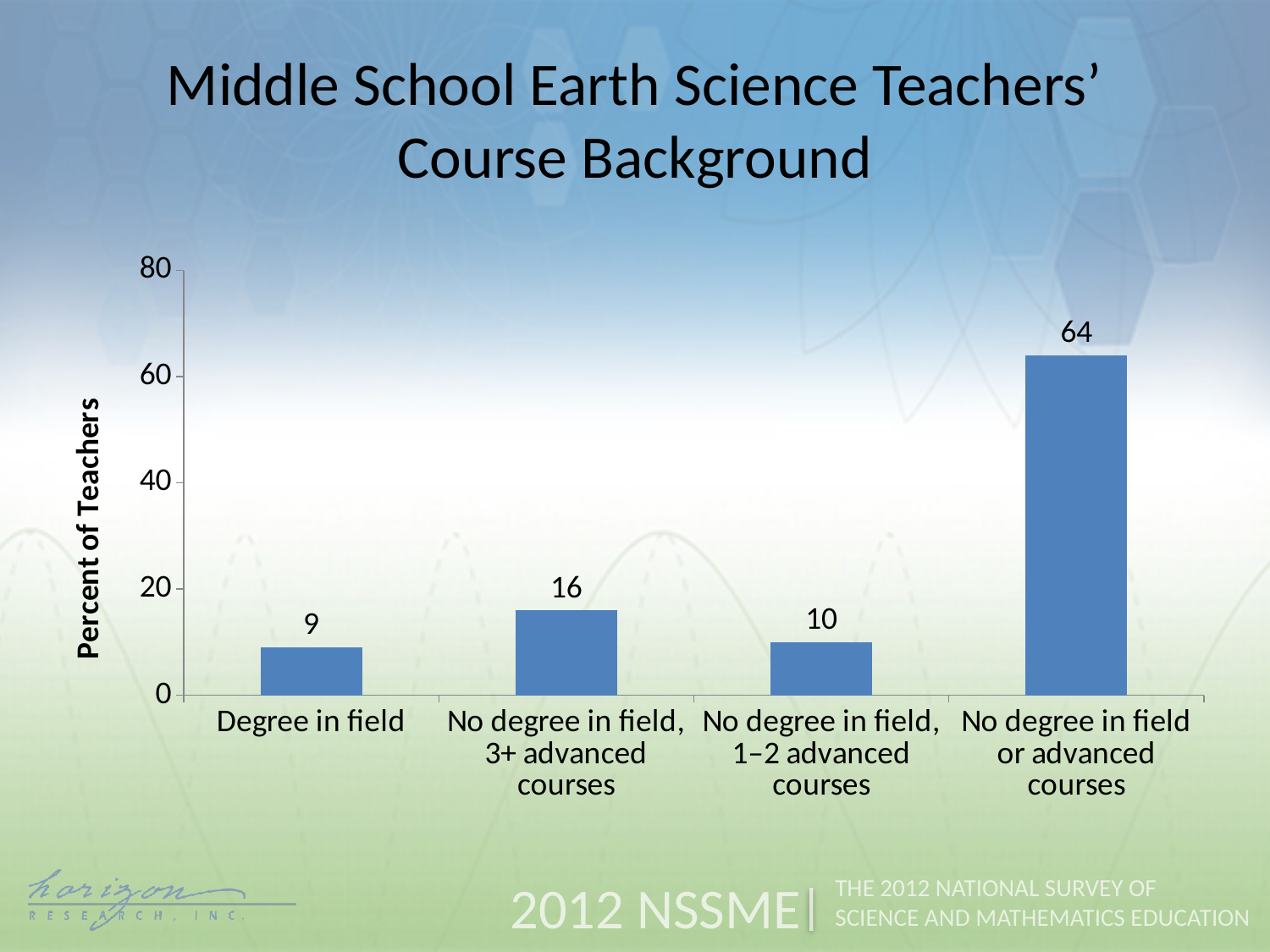
What is the label of the vertical axis? Percent of Teachers Is the value for 'No degree in field or advanced courses' greater or less than 60? greater What percent of teachers have no degree in field and 1–2 advanced courses? 10 Which category has the highest percent of teachers? No degree in field or advanced courses What percent of teachers have no degree in field but 3+ advanced courses? 16 What kind of chart is shown on the slide? Bar chart What percent of teachers have no degree in field or advanced courses? 64 What percent of teachers have a degree in field? 9 What is the difference in percent of teachers between 'No degree in field or advanced courses' and 'Degree in field'? 55 Which category has the lowest percent of teachers? Degree in field How many categories are shown on the chart? 4 Which is larger: the percent of teachers with no degree in field and 3+ advanced courses, or with no degree in field and 1–2 advanced courses? No degree in field, 3+ advanced courses